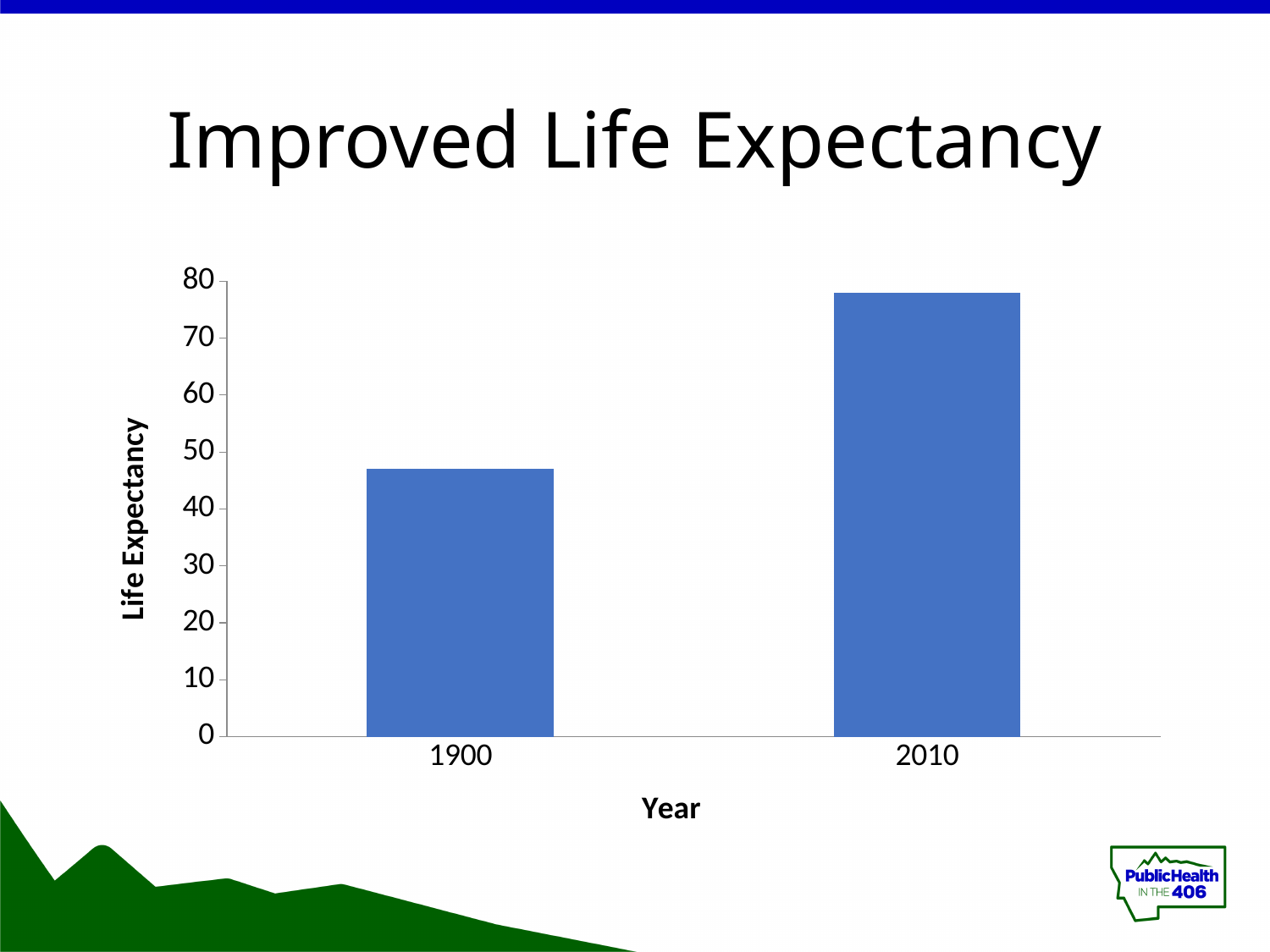
Is the life expectancy for 2010 greater or less than 70? greater Is the life expectancy for 1900 greater or less than 50? less How many years are plotted on the x axis? 2 Does life expectancy rise or fall from 1900 to 2010? rise What kind of chart is shown on the slide? bar chart Is the life expectancy for 2010 greater or less than 80? less Which year has the higher life expectancy? 2010 What is the label on the vertical axis? Life Expectancy Is the value for 2010 larger or smaller than the value for 1900? larger Which year has the lower life expectancy? 1900 What is the label on the horizontal axis? Year